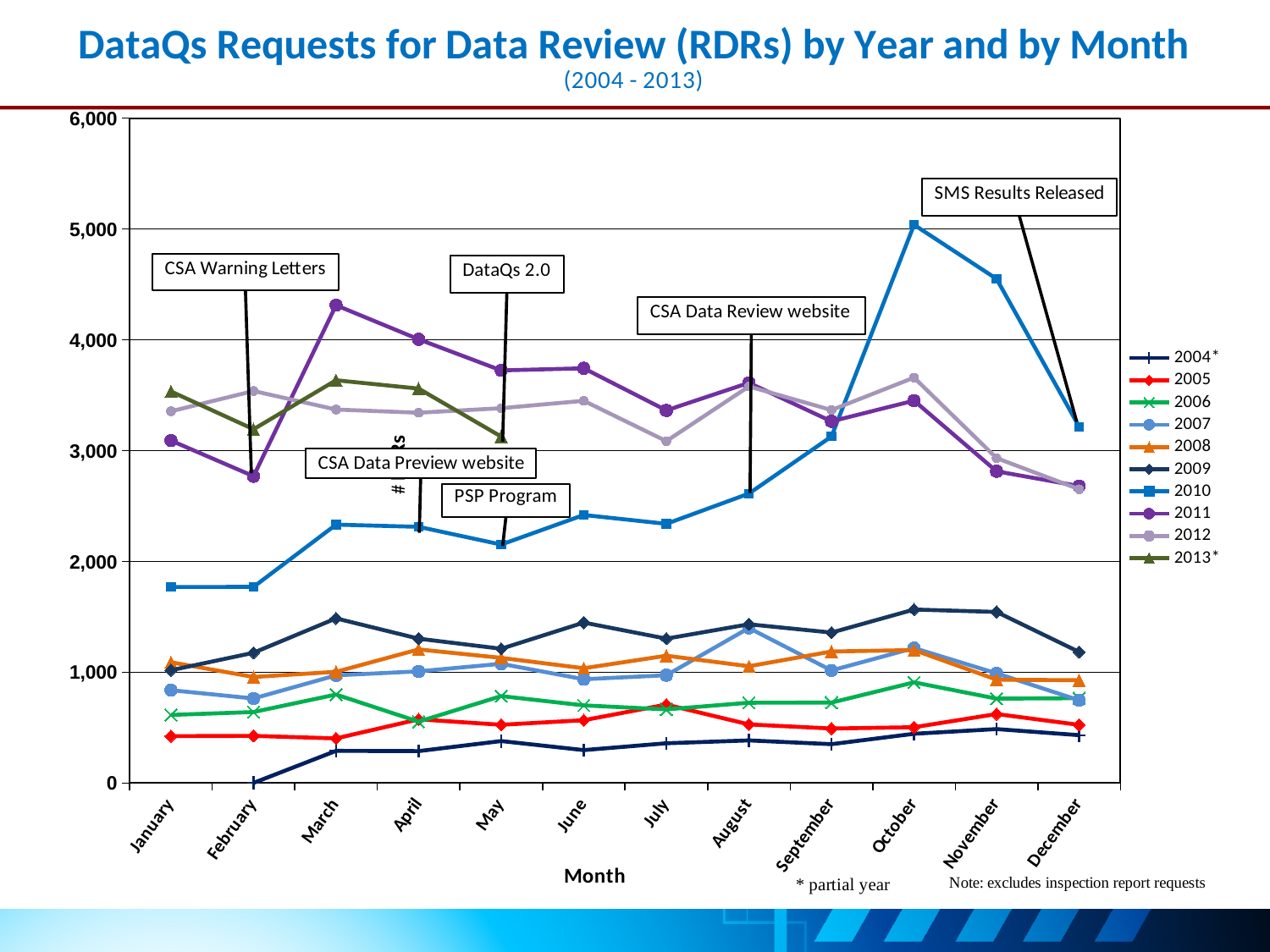
In which month does the 2010 series reach its highest value? October Does the 2010 series rise or fall from October to December? fall In October, which series has the higher value, 2010 or 2012? 2010 Is the 2005 value for January greater or less than 1,000? less Is the 2010 value for October greater or less than 4,000? greater Is the 2011 value for March greater or less than 4,000? greater What kind of chart is shown on the slide? line chart In which month does the 2011 series reach its highest value? March How many series does the legend list? 10 In March, which series has the higher value, 2009 or 2008? 2009 How many months are shown along the x axis? 12